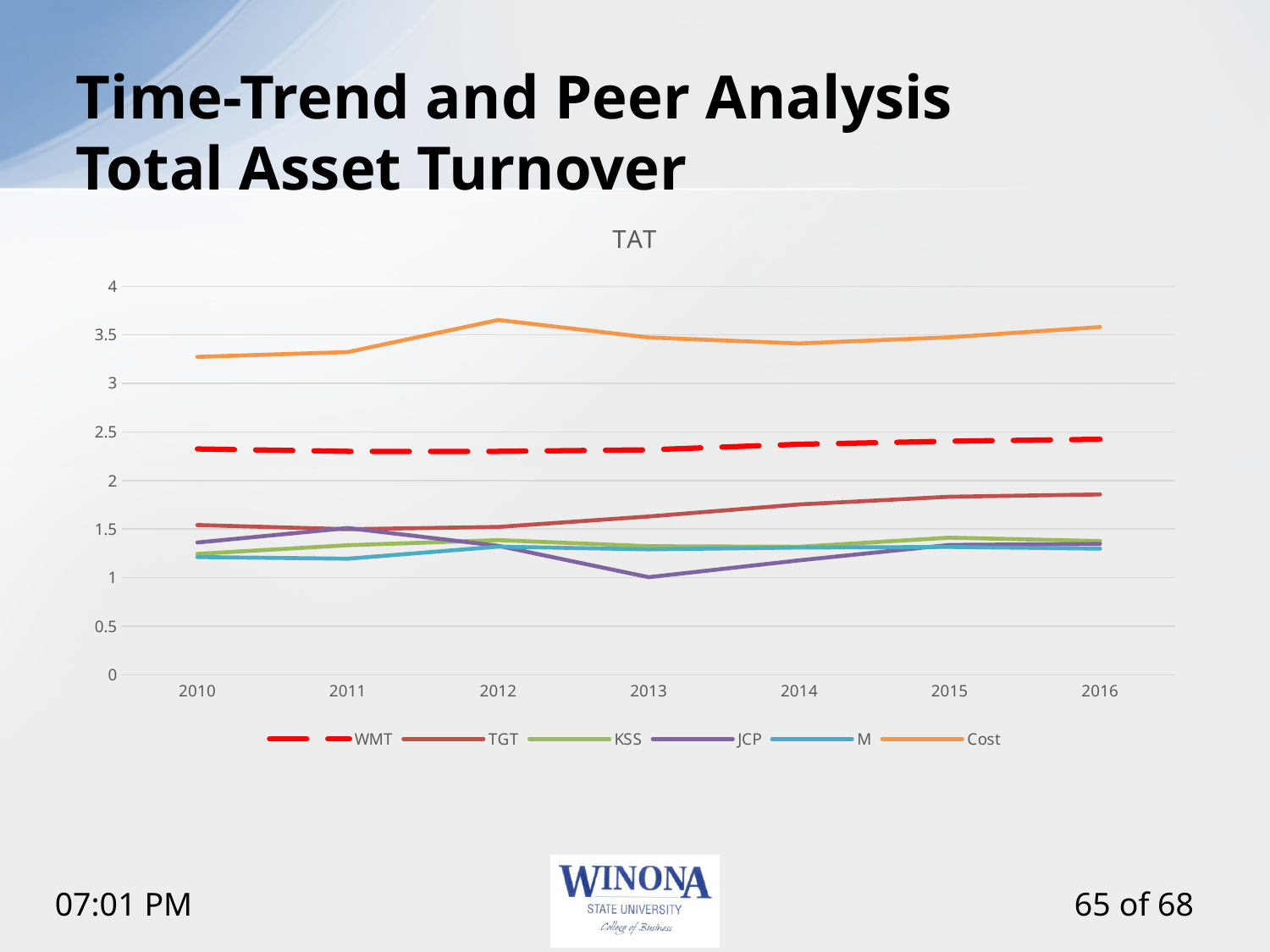
Is the value for TGT in 2016 greater or less than 2? less Is the value for Cost in 2012 greater or less than 3.5? greater How many years are plotted along the x axis? 7 What kind of chart is shown on the slide? line chart What is the title of the chart? TAT Is the value for JCP in 2013 greater or less than 1.5? less Which series has the lowest value in 2013? JCP Which series has the highest values across all years? Cost In 2016, which is larger, the value for Cost or the value for WMT? Cost How many series does the legend list? 6 Does the TGT line rise or fall from 2010 to 2016? rise